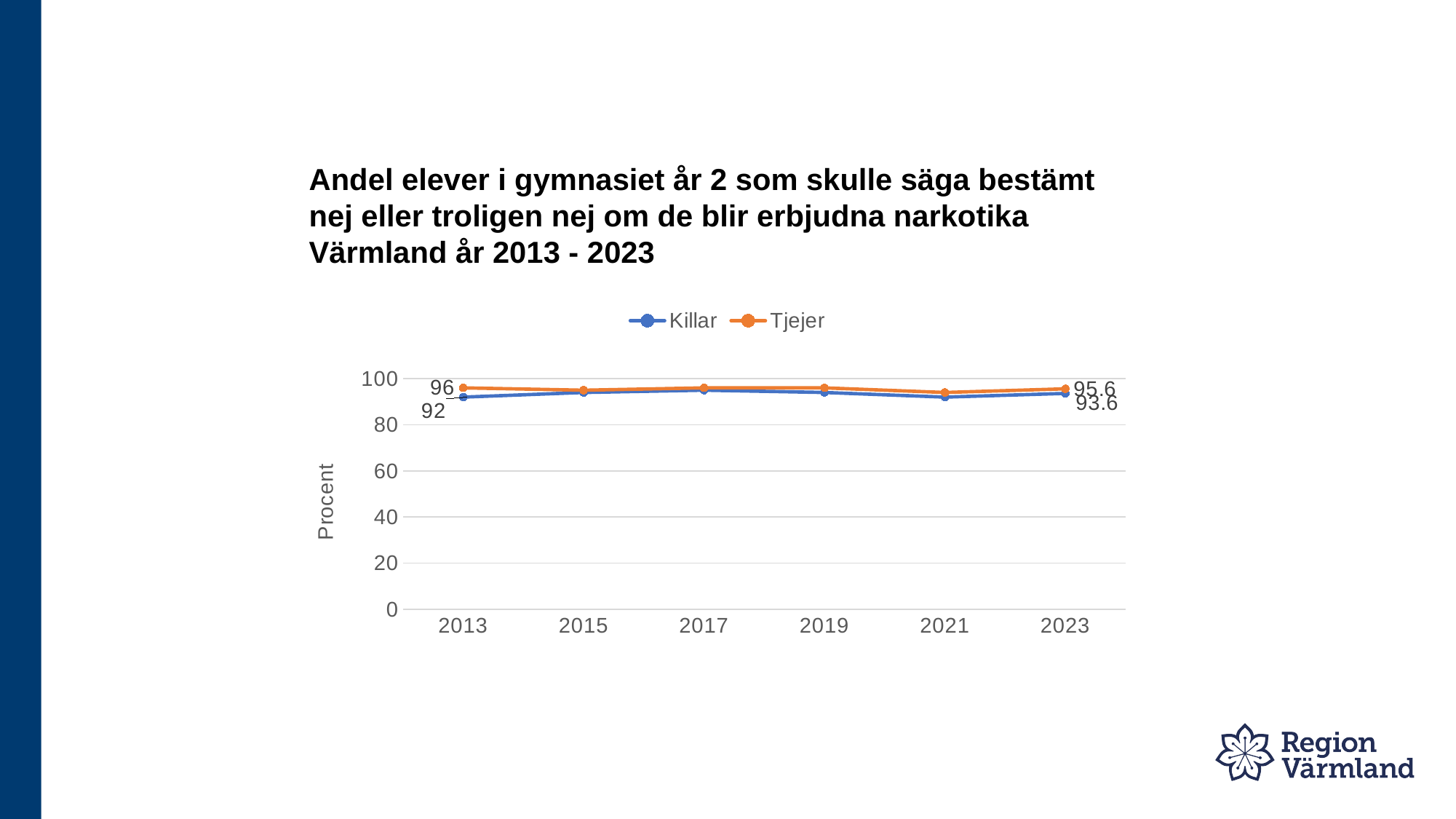
What is the label on the y axis? Procent What is the difference between Tjejer and Killar in 2013? 4 What is the value for Killar in 2013? 92 What is the difference between Tjejer and Killar in 2023? 2 What is the value for Tjejer in 2023? 95.6 How many series does the legend list? 2 Which series has the higher value in 2013, Killar or Tjejer? Tjejer What is the value for Tjejer in 2013? 96 Is the value for Killar in 2021 greater or less than 80? greater What kind of chart is shown on the slide? line chart What is the value for Killar in 2023? 93.6 How many years are shown on the x axis? 6